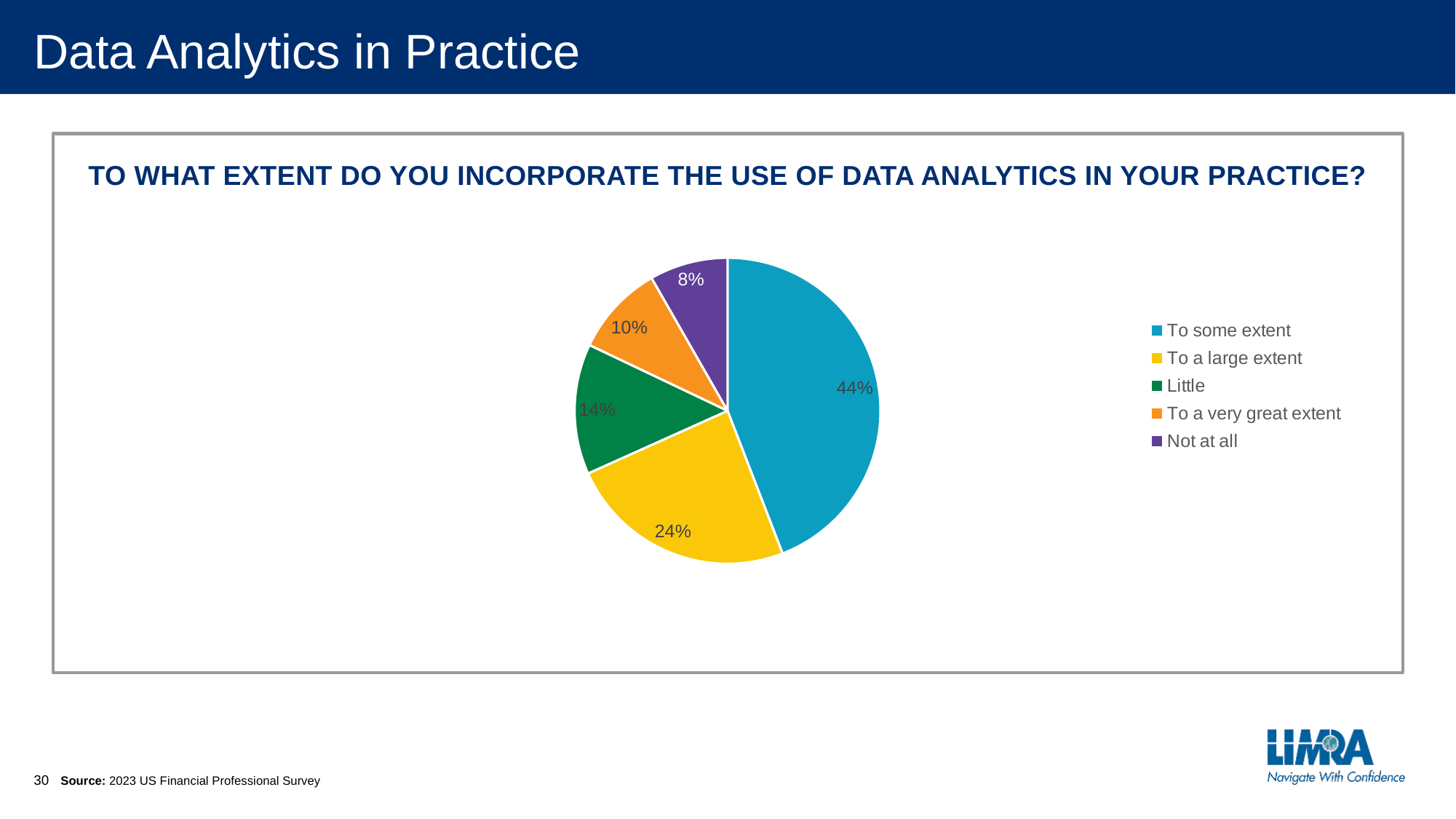
What percentage of respondents answered "Not at all"? 8% What percentage of respondents answered "To a very great extent"? 10% Which response category has the largest share of the pie? To some extent Which response category has the smallest share of the pie? Not at all Which is larger, the share for "Little" or the share for "To a very great extent"? Little What percentage of respondents answered "To a large extent"? 24% What kind of chart is shown on the slide? pie chart What percentage of respondents answered "To some extent"? 44% How many response categories does the pie chart show? 5 What percentage of respondents answered "Little"? 14% What colour is the slice for "Not at all"? purple What is the difference in percentage points between "To some extent" and "To a large extent"? 20